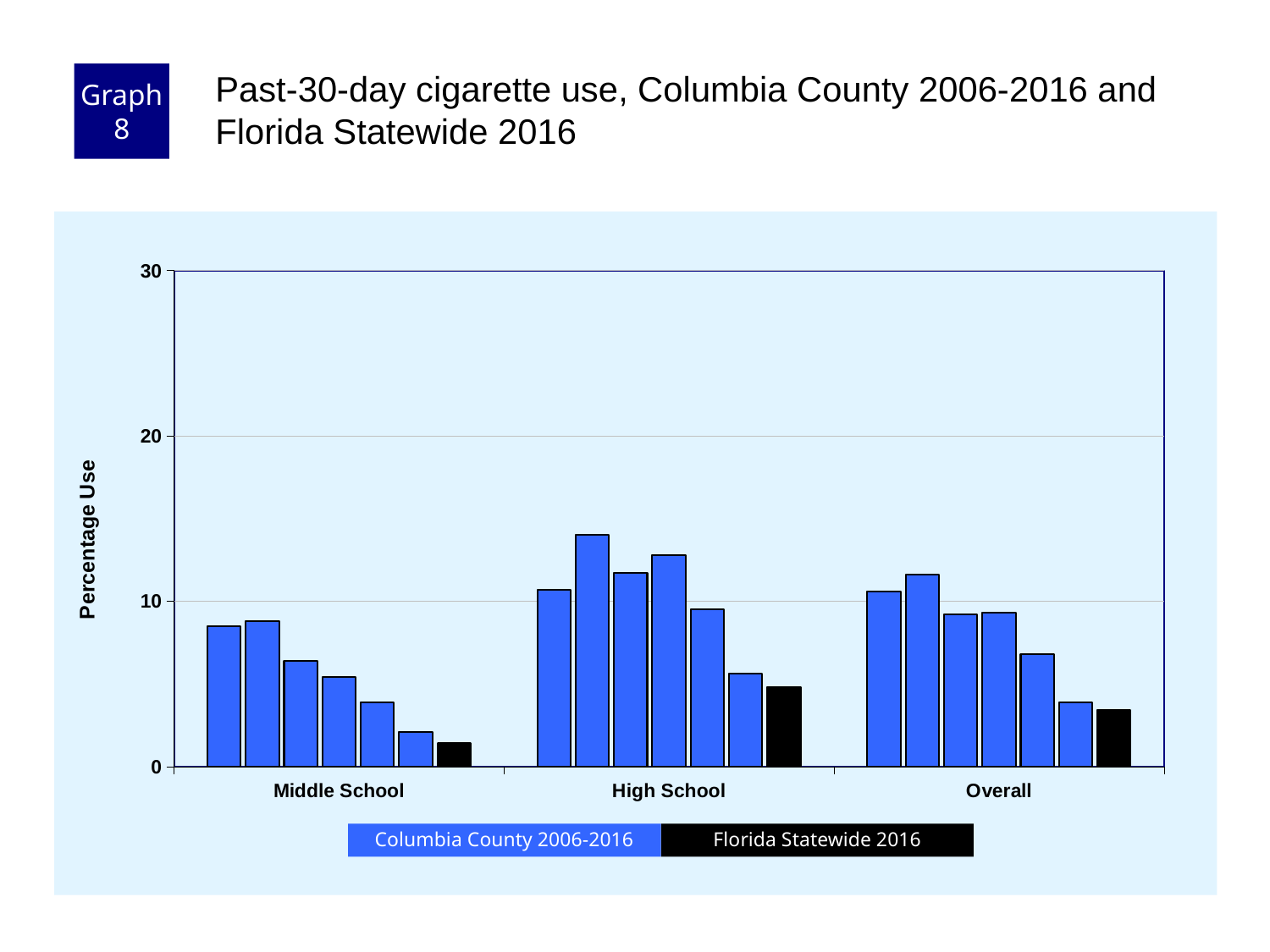
How many series does the legend list? 2 Which category group contains the tallest bar on the chart? High School Is the tallest Columbia County 2006-2016 bar in the High School group greater or less than 10? greater What is the title of the y axis? Percentage Use Do the Columbia County 2006-2016 bars in the Middle School group rise or fall from left to right? fall Is the tallest Columbia County 2006-2016 bar in the Middle School group greater or less than 10? less Which is larger, the Florida Statewide 2016 value for High School or for Middle School? High School Which category group has the lowest Florida Statewide 2016 value? Middle School How many category groups are shown on the x axis? 3 Is the Florida Statewide 2016 value for High School greater or less than 10? less What kind of chart is shown on the slide? bar chart